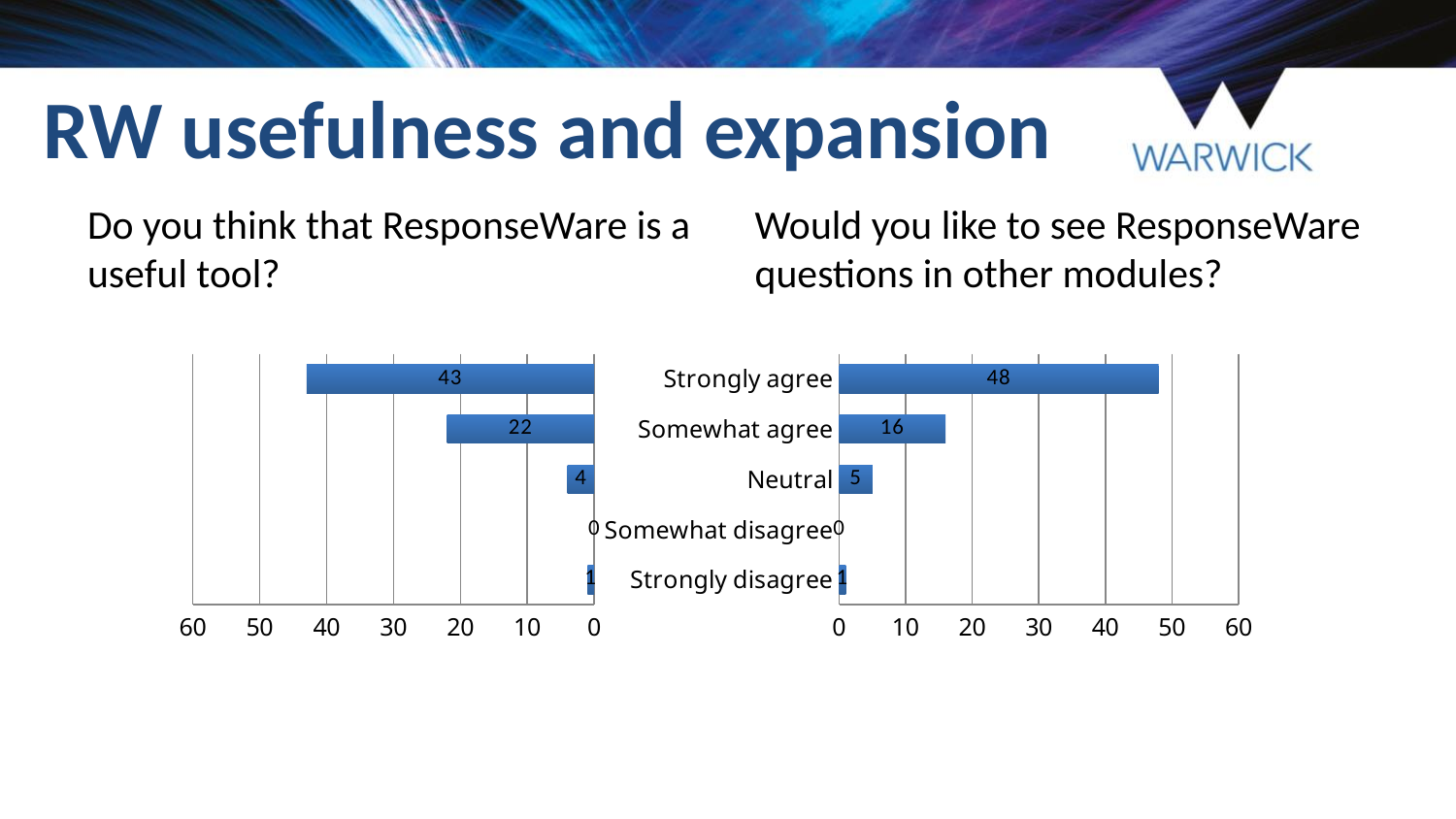
In the right chart (Would you like to see ResponseWare questions in other modules?), what is the value for Strongly disagree? 1 In the left chart (Do you think that ResponseWare is a useful tool?), which category has the lowest value? Somewhat disagree In the right chart (Would you like to see ResponseWare questions in other modules?), is the value for Strongly agree greater or less than 40? greater Which chart has the larger value for Strongly agree, the left chart or the right chart? The right chart In the left chart (Do you think that ResponseWare is a useful tool?), what is the value for Strongly agree? 43 In the left chart (Do you think that ResponseWare is a useful tool?), what is the value for Neutral? 4 In the left chart (Do you think that ResponseWare is a useful tool?), what is the difference between Strongly agree and Somewhat agree? 21 How many categories are shown in the left chart (Do you think that ResponseWare is a useful tool?)? 5 In the right chart (Would you like to see ResponseWare questions in other modules?), what is the value for Somewhat agree? 16 In the right chart (Would you like to see ResponseWare questions in other modules?), which category has the highest value? Strongly agree What kind of chart is the right chart (Would you like to see ResponseWare questions in other modules?)? Bar chart In the right chart (Would you like to see ResponseWare questions in other modules?), what is the difference between Strongly agree and Neutral? 43